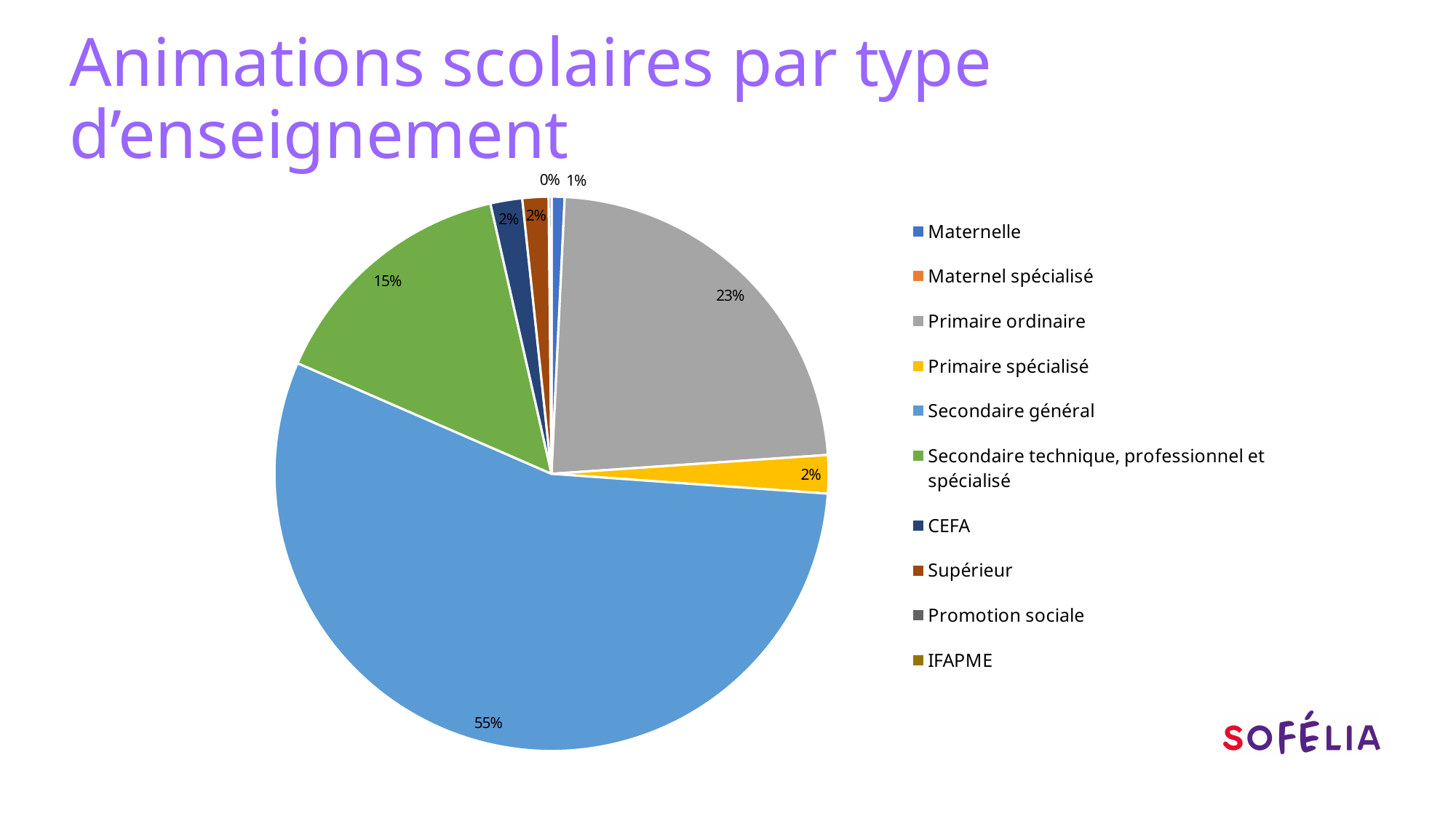
How many categories does the legend list? 10 What percentage is shown for Maternelle? 1% What percentage is shown for Primaire spécialisé? 2% By how many percentage points does Secondaire général exceed Primaire ordinaire? 32 percentage points Which type of enseignement has the largest slice of the pie? Secondaire général Which is larger: the slice for Primaire ordinaire or the slice for Secondaire technique, professionnel et spécialisé? Primaire ordinaire What percentage is shown for Secondaire technique, professionnel et spécialisé? 15% What percentage is shown for Primaire ordinaire? 23% What is the title of the slide containing the pie chart? Animations scolaires par type d’enseignement What share of the pie does Secondaire général represent? 55% What percentage is shown for CEFA? 2% What kind of chart is shown on the slide? pie chart